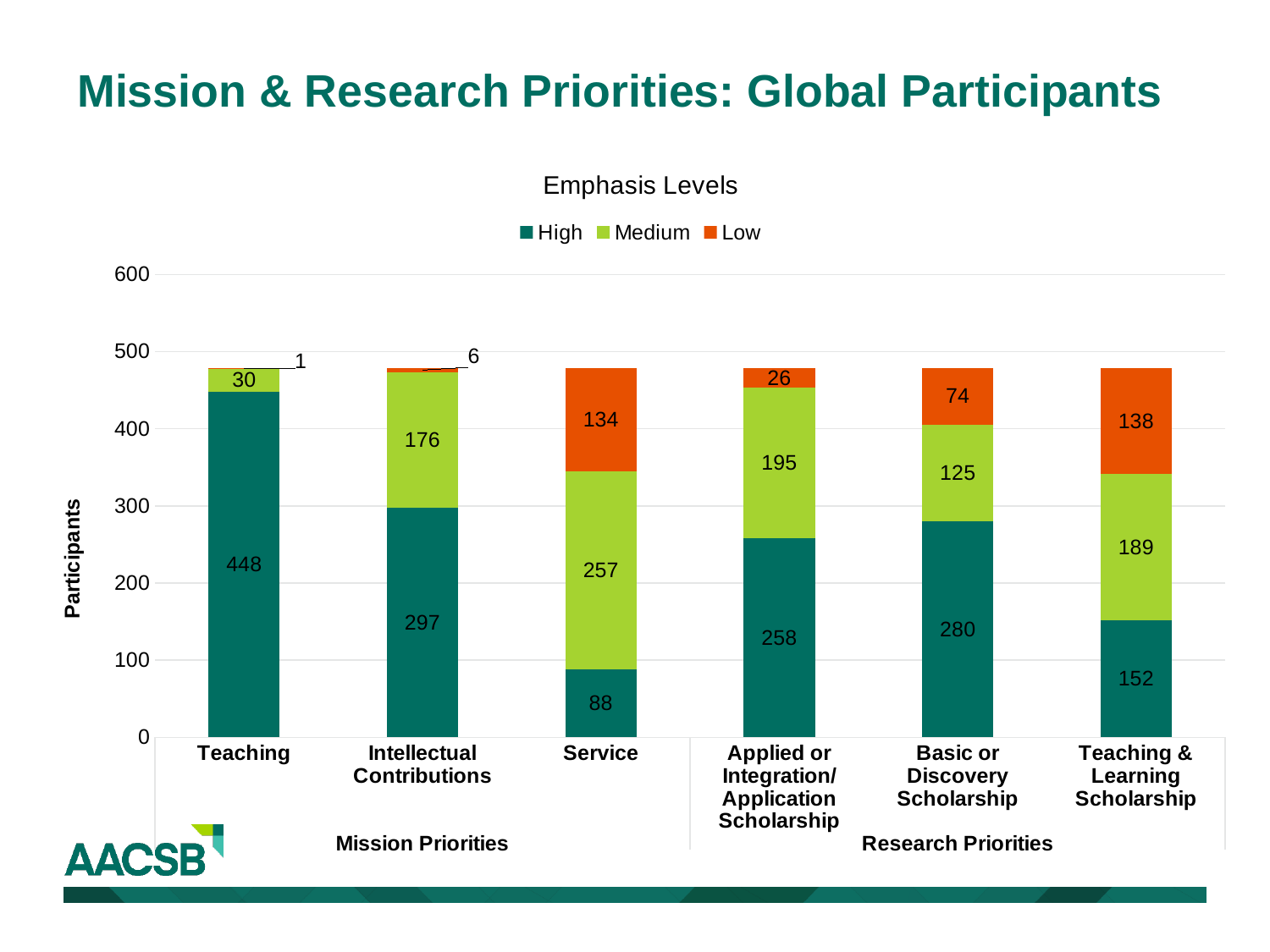
How many categories are shown on the x axis? 6 Which category has the lowest Low value? Teaching What is the total of the stacked bar for Service? 479 Which is larger, the Medium value for Intellectual Contributions or the Medium value for Teaching & Learning Scholarship? Teaching & Learning Scholarship What kind of chart is shown? Stacked bar chart What is the Medium value for Service? 257 What is the High value for Teaching & Learning Scholarship? 152 What is the Low value for Basic or Discovery Scholarship? 74 Which category has the highest High value? Teaching What is the High value for Teaching? 448 How many series does the legend list? 3 What is the difference between the High values for Basic or Discovery Scholarship and Applied or Integration/Application Scholarship? 22